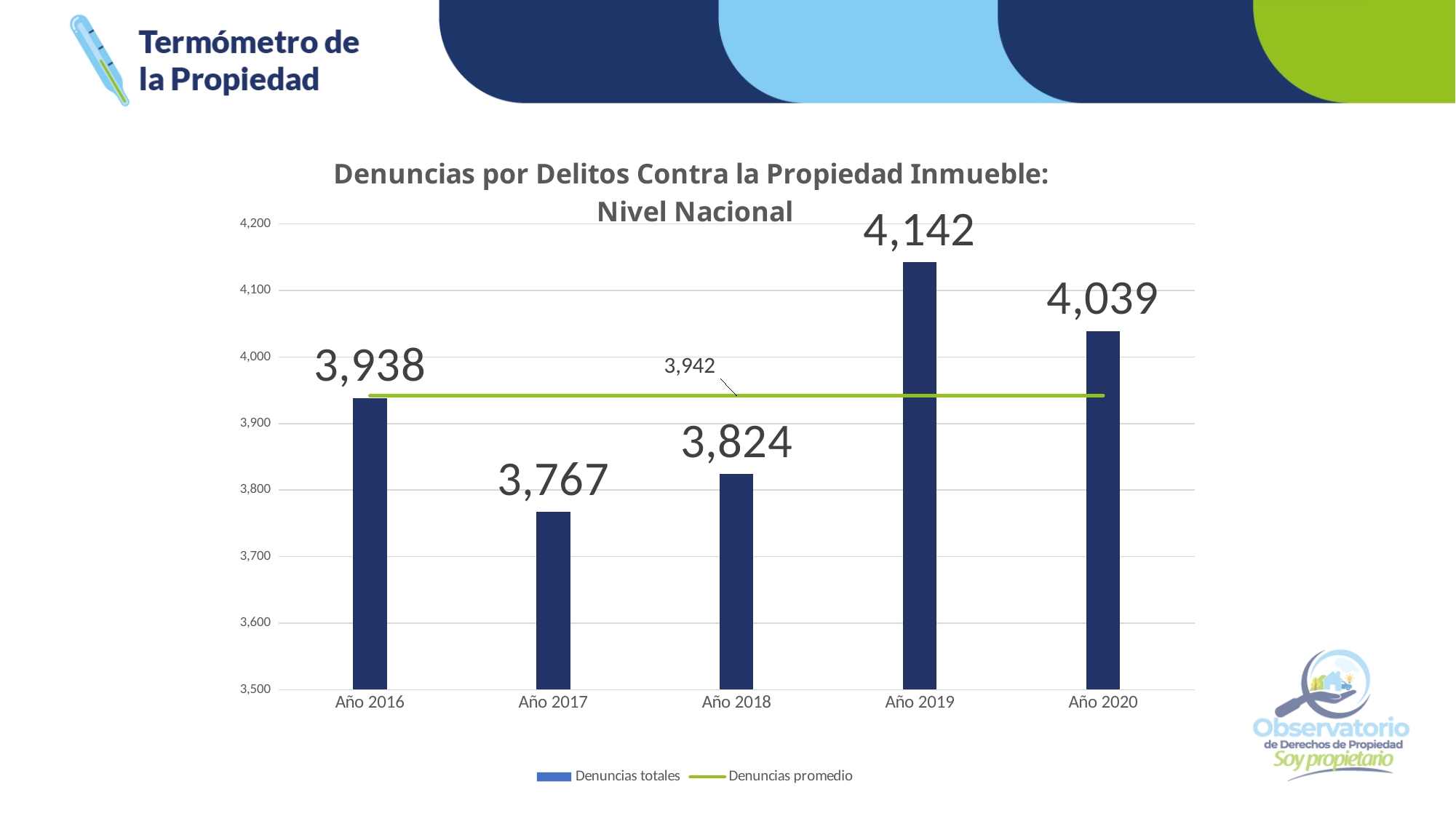
Is the value for Año 2017 greater or less than 3,800? less What is the value of Denuncias totales for Año 2019? 4,142 What is the difference in Denuncias totales between Año 2019 and Año 2017? 375 How many series does the legend list? 2 What value is labelled on the Denuncias promedio line? 3,942 How many years are shown on the x axis? 5 Which is larger, Denuncias totales for Año 2018 or for Año 2016? Año 2016 What kind of chart is used for Denuncias totales? bar chart What is the value of Denuncias totales for Año 2016? 3,938 Which year has the lowest Denuncias totales? Año 2017 What is the value of Denuncias totales for Año 2020? 4,039 Which year has the highest Denuncias totales? Año 2019